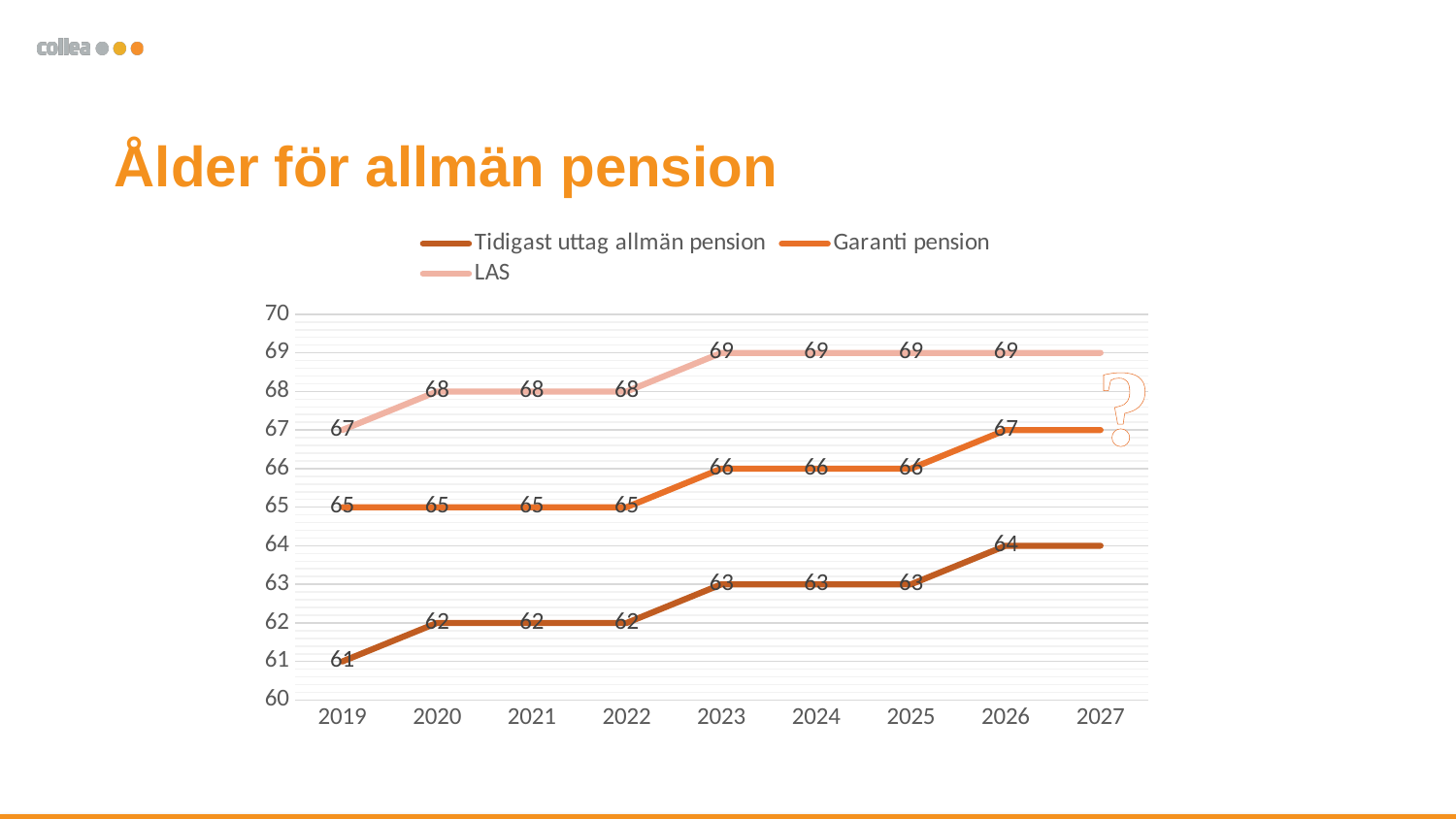
How many series does the legend list? 3 What is the difference between LAS and Garanti pension in 2020? 3 What is the title of the chart? Ålder för allmän pension What is the value of LAS in 2023? 69 Do the values of Garanti pension rise or fall from 2019 to 2026? rise What is the value of Tidigast uttag allmän pension in 2019? 61 Which is larger in 2022: Garanti pension or Tidigast uttag allmän pension? Garanti pension What type of chart is shown on the slide? line chart What is the value of Tidigast uttag allmän pension in 2024? 63 Which series has the highest value in 2025? LAS What is the difference between Tidigast uttag allmän pension in 2026 and in 2019? 3 What is the value of Garanti pension in 2026? 67